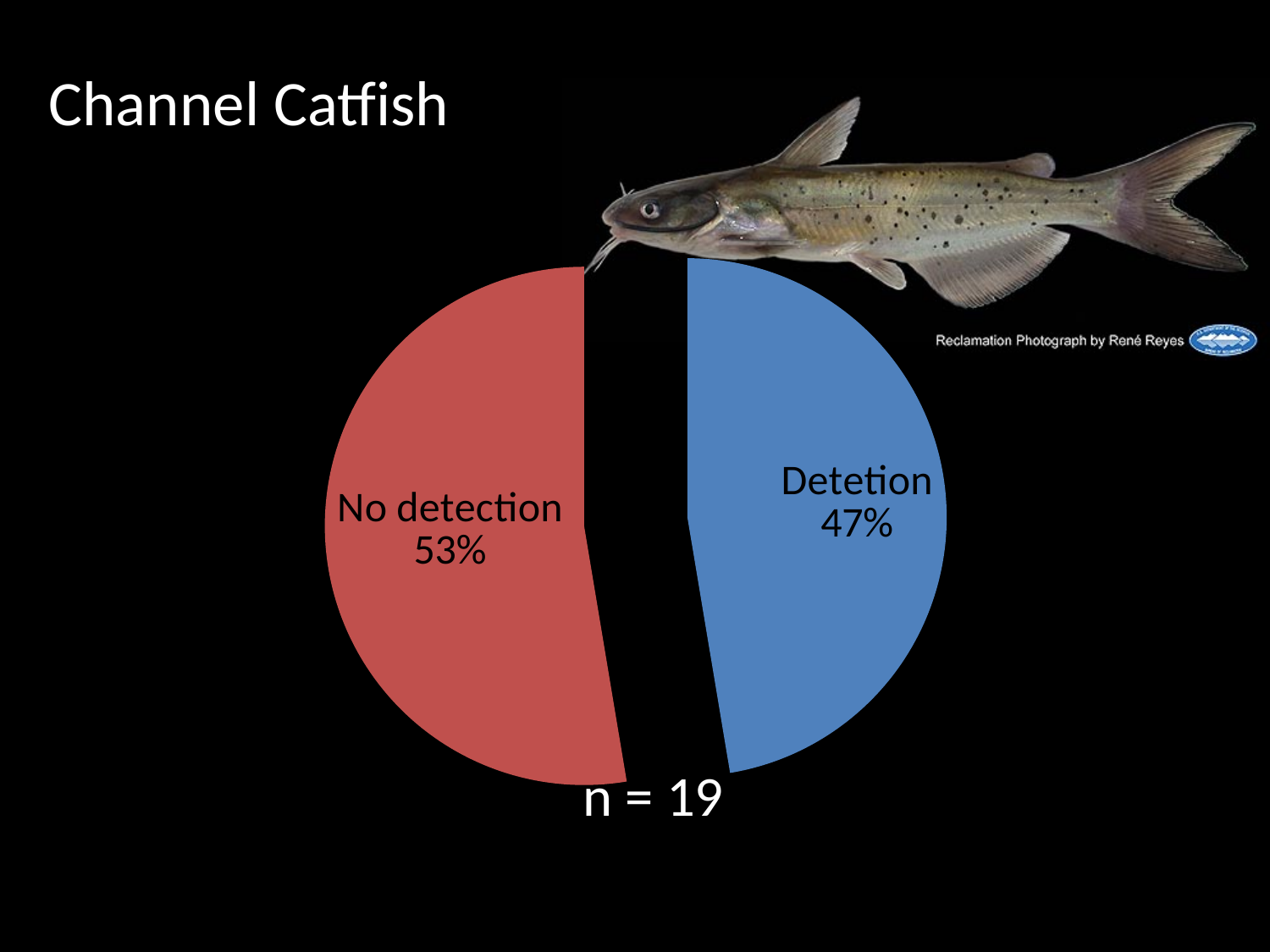
What share of the pie is labelled "Detetion"? 47% How many slices does the pie chart have? 2 What share of the pie is labelled "No detection"? 53% What is the difference in percentage points between the "No detection" and "Detetion" slices? 6 Which slice of the pie is the smallest? Detetion Which slice of the pie is the largest? No detection Is the "Detetion" share greater or less than 50%? less Which is larger, the "No detection" slice or the "Detetion" slice? No detection What kind of chart is shown on the slide? Pie chart What colour is the "No detection" slice? Red What is the sample size (n) shown below the pie chart? n = 19